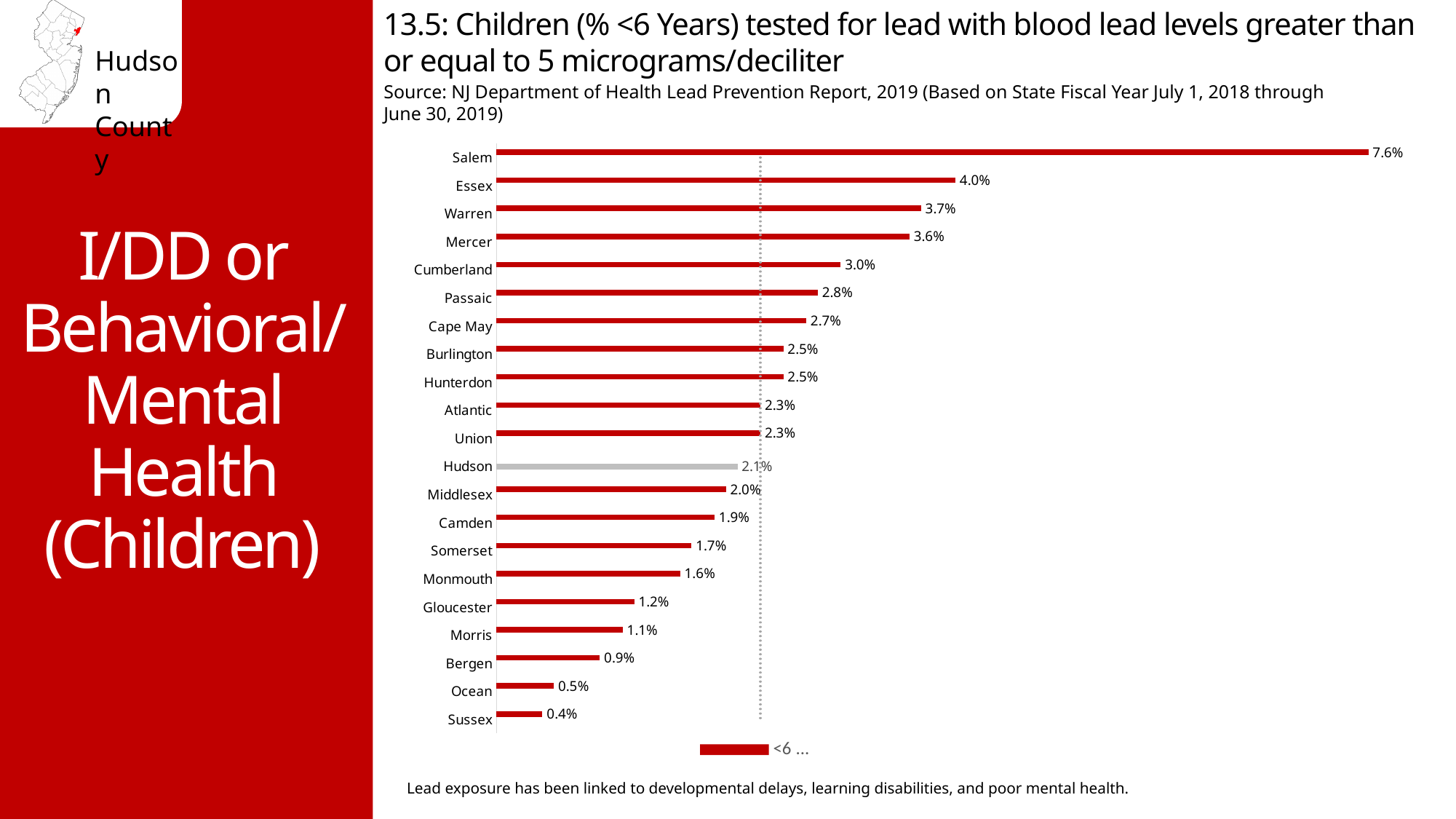
What is the difference between the values for Essex and Hudson? 1.9% Which county has the lowest percentage in the chart? Sussex What kind of chart is shown on the slide? Bar chart Which has a higher value, Mercer or Cumberland? Mercer How many counties are shown in the chart? 21 Which county's bar is drawn in gray instead of red? Hudson Which has a higher value, Camden or Middlesex? Middlesex What is the value shown for Hudson? 2.1% What percentage of children tested in Salem had blood lead levels greater than or equal to 5 micrograms/deciliter? 7.6% Which county has the highest percentage in the chart? Salem What is the difference between the values for Salem and Sussex? 7.2% What is the value shown for Bergen? 0.9%